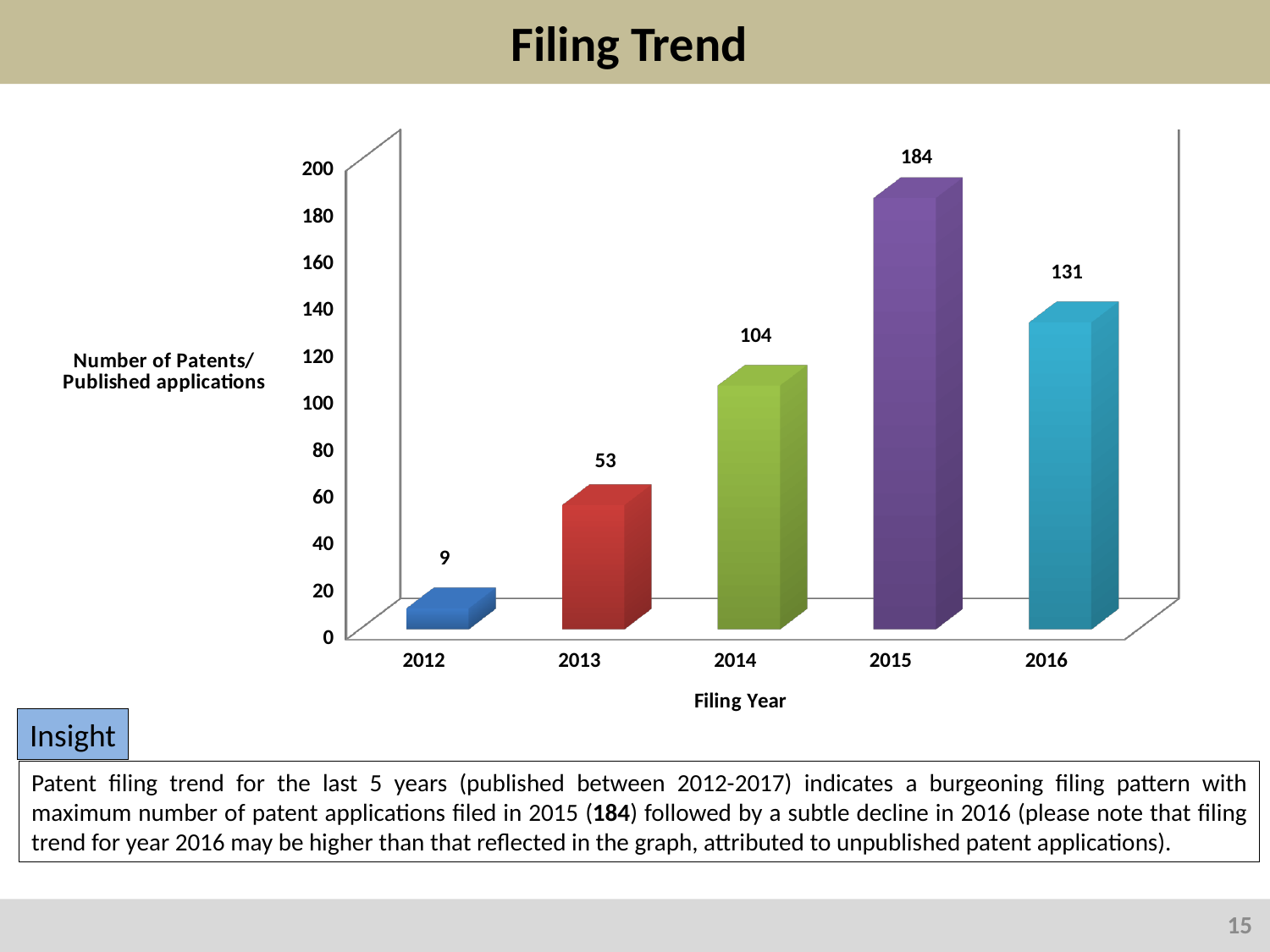
Which filing year has the highest number of patents/published applications? 2015 What is the number of patents/published applications for filing year 2014? 104 Which filing year has a larger value, 2014 or 2016? 2016 Which filing year has the lowest number of patents/published applications? 2012 What is the label of the x axis? Filing Year What is the number of patents/published applications for filing year 2012? 9 Is the value for 2013 greater or less than 60? less What kind of chart is shown on the slide? bar chart What is the difference between the values for 2013 and 2012? 44 How many filing years are shown on the x axis? 5 What is the difference between the values for 2015 and 2016? 53 What is the number of patents/published applications for filing year 2016? 131